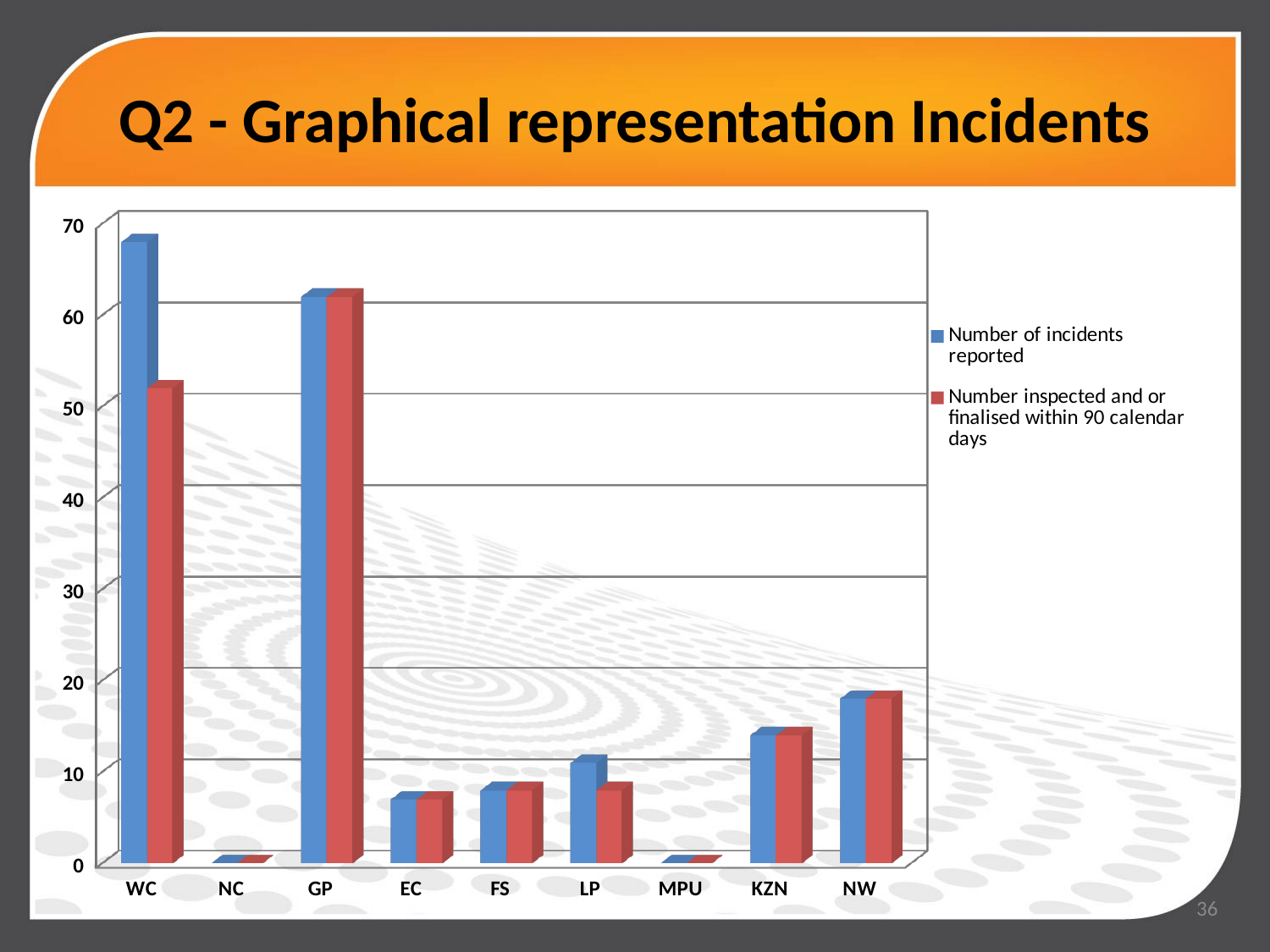
Is the number of incidents reported for EC greater or less than 10? less Which province has the highest number of incidents reported? WC Which is larger: the number of incidents reported for WC or for GP? WC What is the title of the slide containing the chart? Q2 - Graphical representation Incidents How many series does the chart's legend list? 2 What kind of chart is shown on the slide? bar chart How many provinces (categories) are shown on the x axis of the chart? 9 Which is larger for WC: the number of incidents reported or the number inspected and or finalised within 90 calendar days? Number of incidents reported Is the number of incidents reported for NW greater or less than 20? less Is the number of incidents reported for WC greater or less than 60? greater Which province has the highest number inspected and or finalised within 90 calendar days? GP